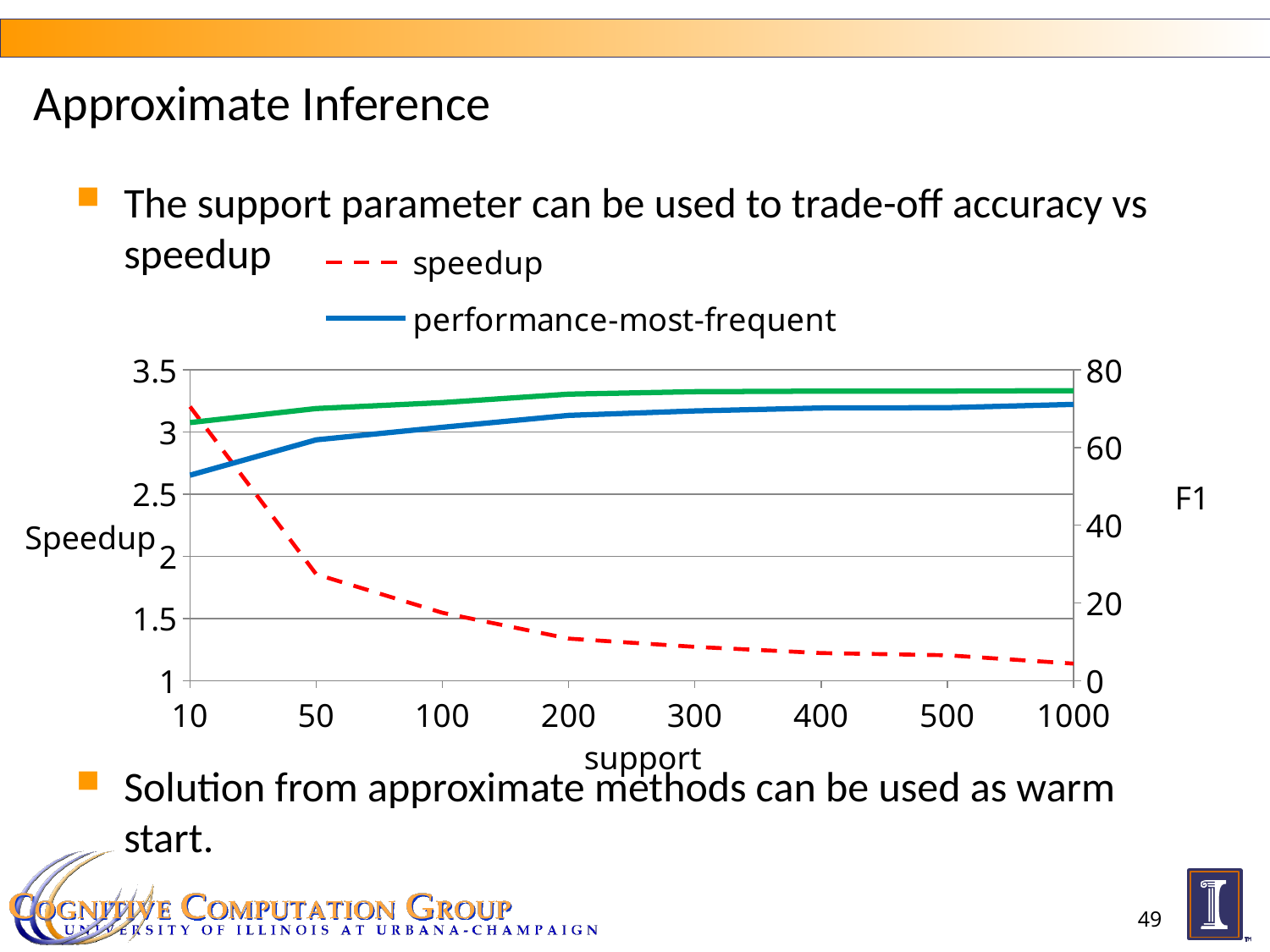
At which support value is speedup lowest? 1000 Is the speedup at support 10 greater or less than 3? greater How many support values are marked along the x axis of the chart? 8 Is the speedup at support 10 larger or smaller than the speedup at support 100? larger At which support value is speedup highest? 10 Does the performance-most-frequent line rise or fall as support increases along the x axis? rise What kind of chart is shown on the slide? line chart What is the label of the x axis of the chart? support Is the speedup at support 50 greater or less than 2? less Is the speedup at support 1000 greater or less than 1.5? less Does the speedup line rise or fall as support increases along the x axis? fall How many series does the chart's legend list? 2